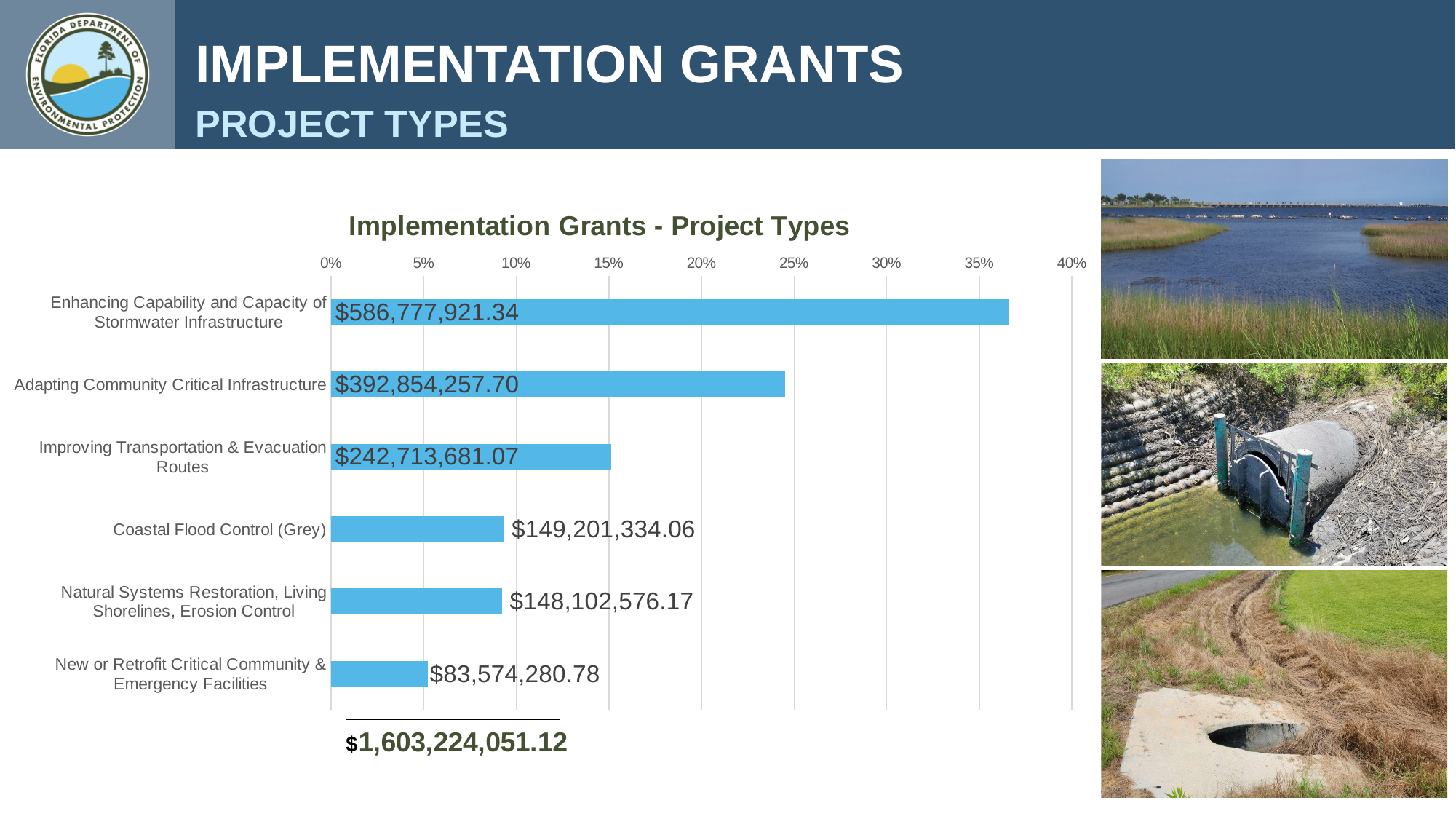
Which project type has the lowest value? New or Retrofit Critical Community & Emergency Facilities What is the value for New or Retrofit Critical Community & Emergency Facilities? $83,574,280.78 Which project type has the highest value? Enhancing Capability and Capacity of Stormwater Infrastructure What is the difference between the values for Coastal Flood Control (Grey) and Natural Systems Restoration, Living Shorelines, Erosion Control? $1,098,757.89 How many project types are shown in the chart? 6 What is the difference between the values for Enhancing Capability and Capacity of Stormwater Infrastructure and Adapting Community Critical Infrastructure? $193,923,663.64 Is the bar for Coastal Flood Control (Grey) greater or less than 10% on the axis? less Is the bar for Enhancing Capability and Capacity of Stormwater Infrastructure greater or less than 35% on the axis? greater What is the value for Enhancing Capability and Capacity of Stormwater Infrastructure? $586,777,921.34 What type of chart is shown on the slide? Bar chart Which is larger: the value for Adapting Community Critical Infrastructure or Improving Transportation & Evacuation Routes? Adapting Community Critical Infrastructure What is the value for Adapting Community Critical Infrastructure? $392,854,257.70